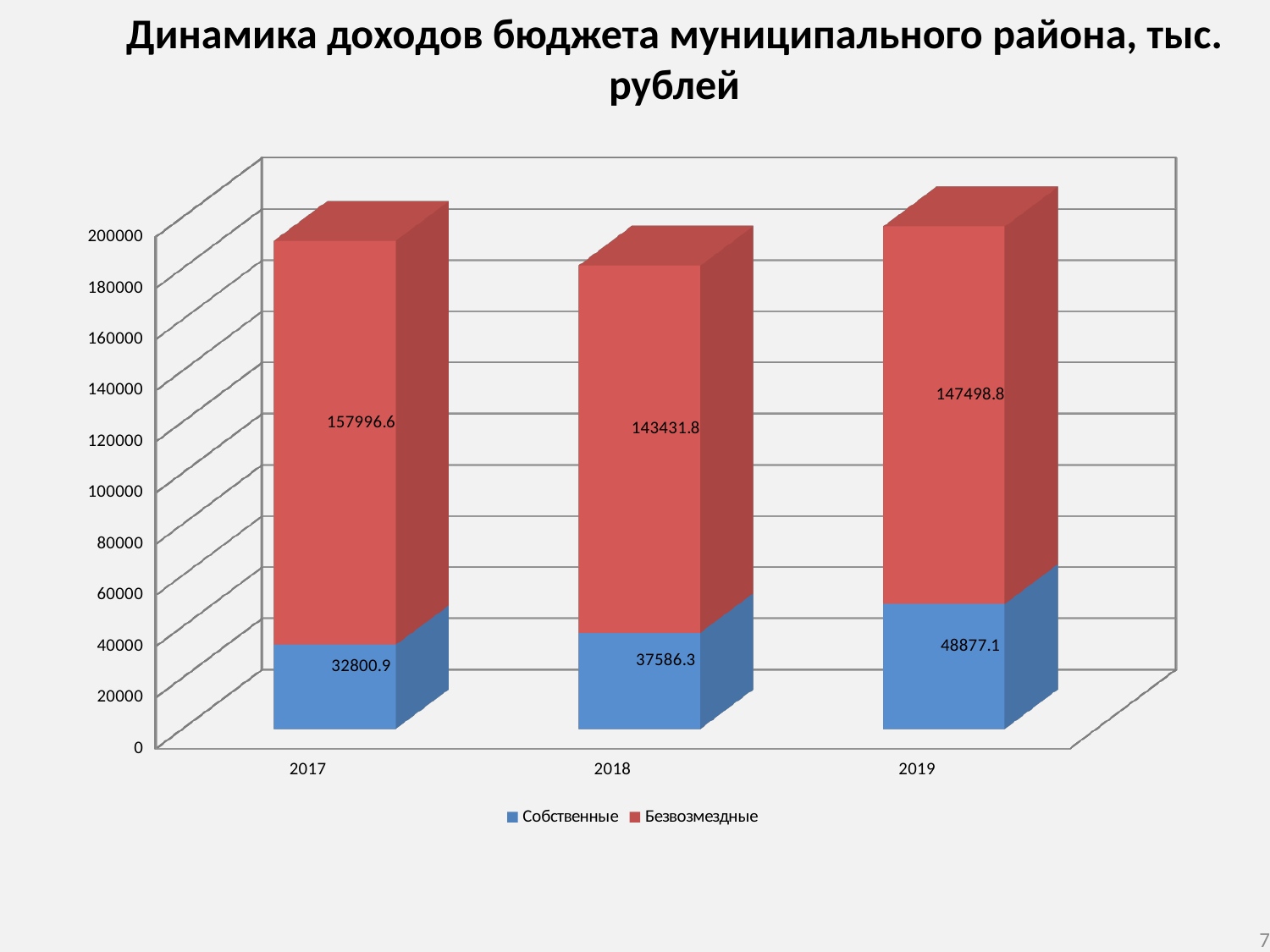
What is the difference between the Собственные values for 2019 and 2017? 16076.2 What is the value of Безвозмездные for 2018? 143431.8 How many years are shown on the x axis? 3 What is the value of Собственные for 2019? 48877.1 In which year is the Собственные value highest? 2019 How many series does the legend list? 2 Do the Собственные values rise or fall from 2017 to 2019? Rise What is the value of Собственные for 2017? 32800.9 What is the total of the stacked bar for 2018? 181018.1 What kind of chart is shown on the slide? Stacked bar chart Which is larger: Безвозмездные in 2017 or Безвозмездные in 2019? 2017 In which year is the Безвозмездные value lowest? 2018